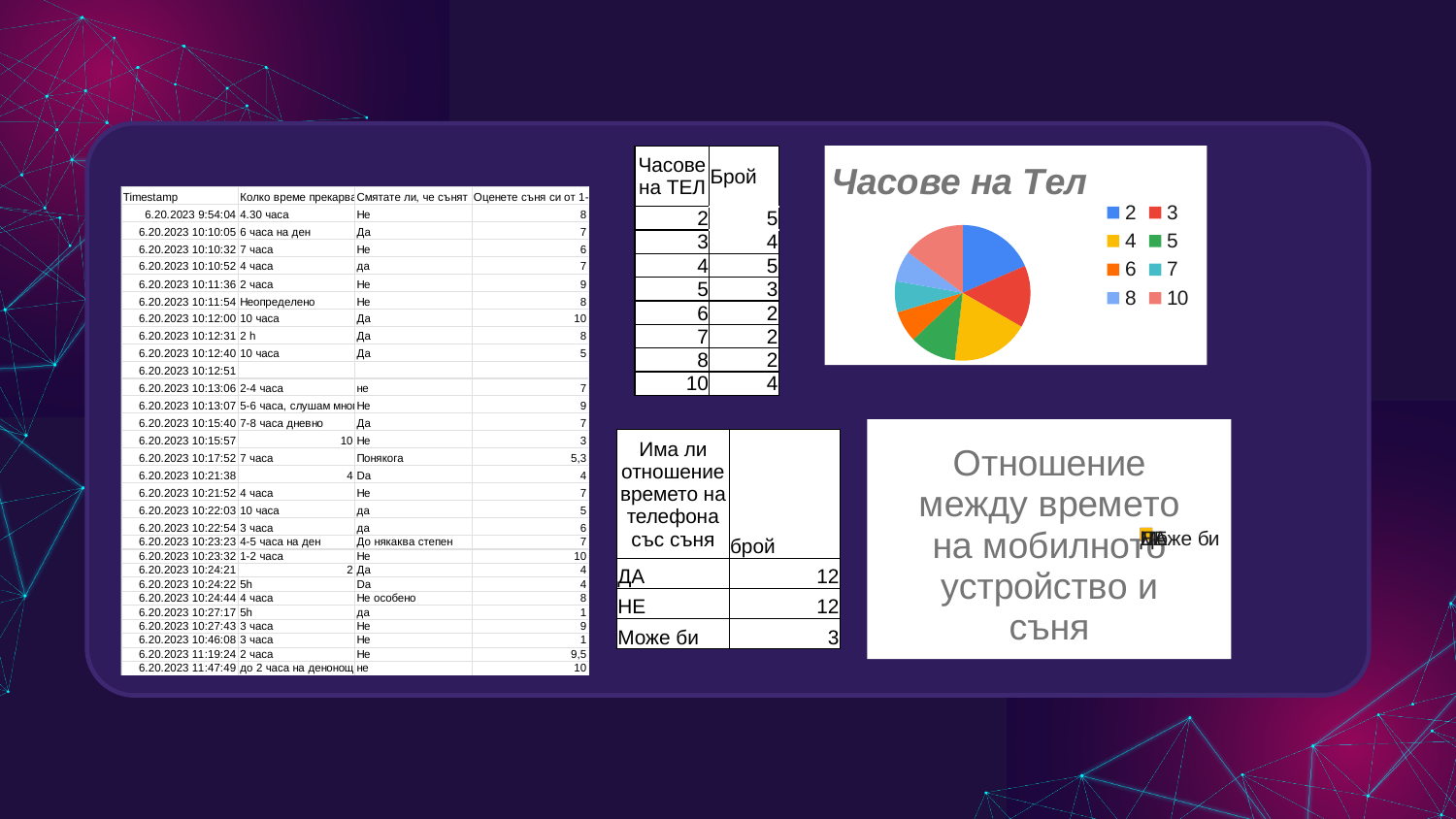
In the "Часове на Тел" pie chart, what colour is the slice for 2 according to the legend? blue How many entries does the legend of the "Часове на Тел" pie chart list? 8 In the "Часове на Тел" pie chart, which slice is larger, the one for 2 or the one for 8? 2 What kind of chart is the chart titled "Часове на Тел"? pie chart In the "Часове на Тел" pie chart, which slice is larger, the one for 10 or the one for 7? 10 In the "Часове на Тел" pie chart, which slice is larger, the one for 2 or the one for 6? 2